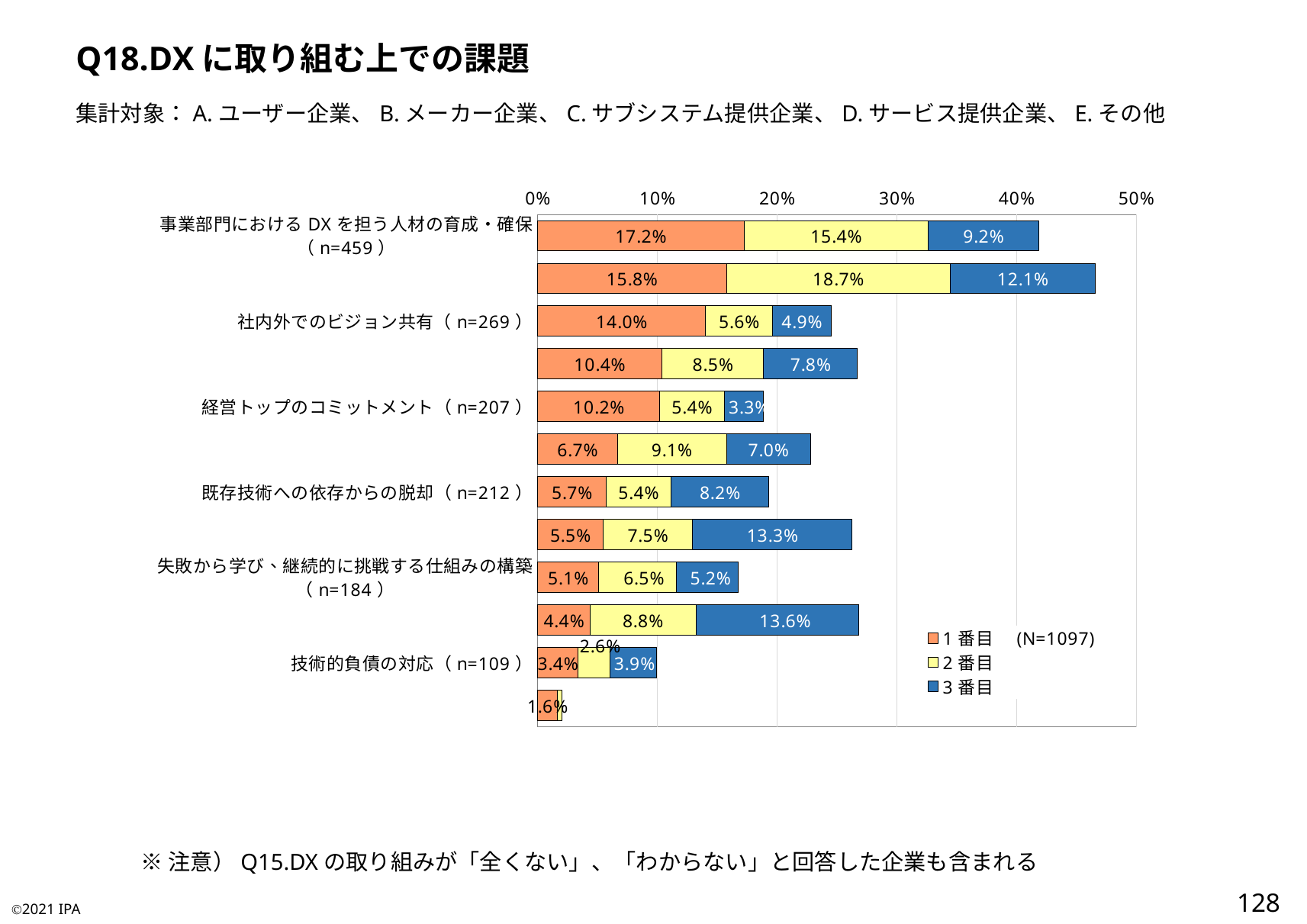
What is the 1番目 value for 技術的負債の対応 (n=109)? 3.4% What is the 1番目 value for 事業部門におけるDXを担う人材の育成・確保 (n=459)? 17.2% How many series does the legend list? 3 What kind of chart is shown on the slide? Stacked bar chart Is the total stacked bar for 事業部門におけるDXを担う人材の育成・確保 greater or less than 40%? greater What is the total of the stacked bar for 経営トップのコミットメント (n=207)? 18.9% What is the 2番目 value for 社内外でのビジョン共有 (n=269)? 5.6% What total N is shown next to the legend? N=1097 Which labeled category has the highest 1番目 value? 事業部門におけるDXを担う人材の育成・確保 What is the 3番目 value for 既存技術への依存からの脱却 (n=212)? 8.2% What is the difference between the 1番目 values for 事業部門におけるDXを担う人材の育成・確保 and 社内外でのビジョン共有? 3.2% Which is larger: the 3番目 value for 既存技術への依存からの脱却 or the 3番目 value for 経営トップのコミットメント? 既存技術への依存からの脱却